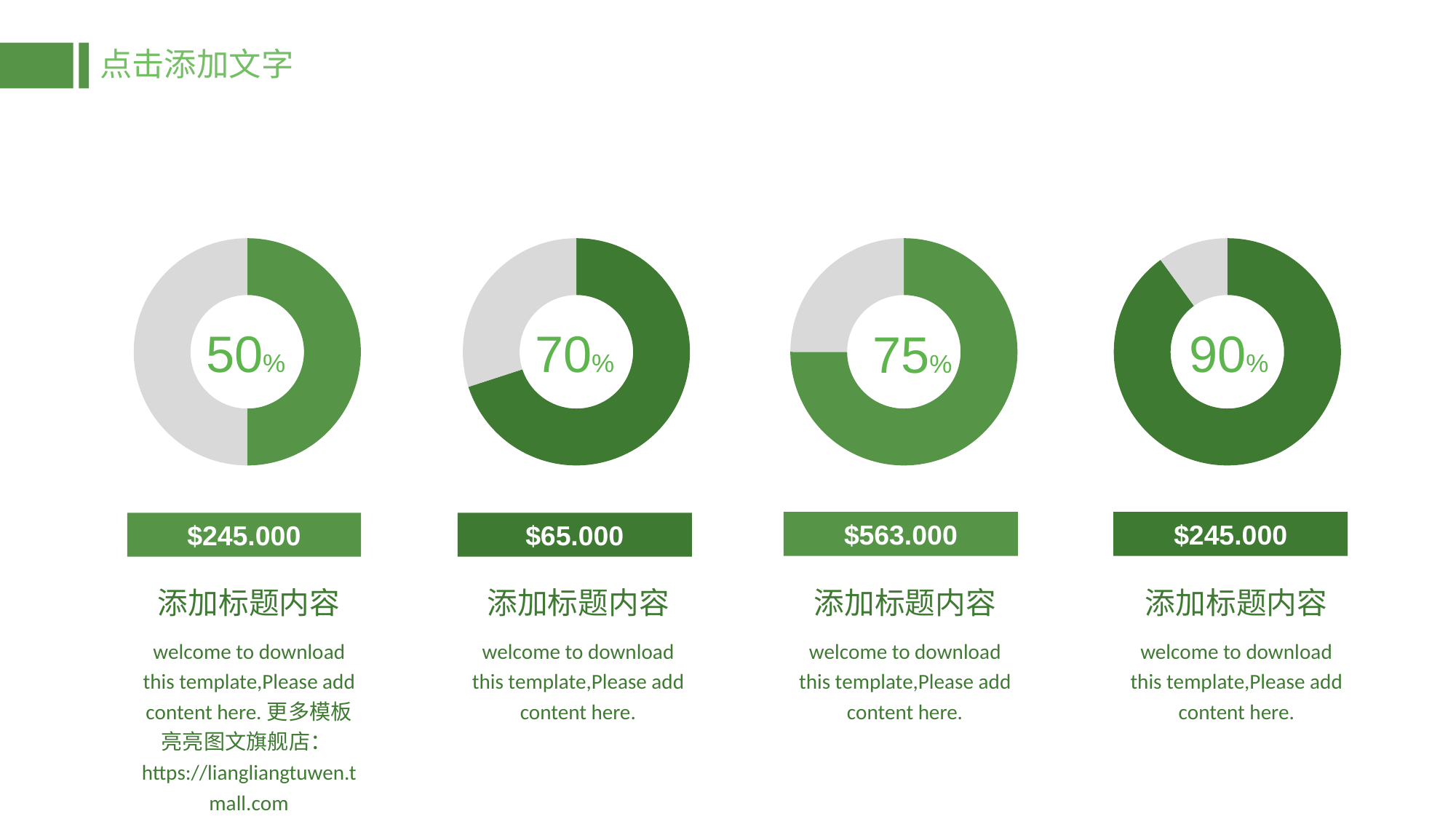
How many donut charts are on the slide? 4 What kind of chart is used four times across the middle of the slide? Donut chart What percentage is shown in the centre of the third donut chart from the left? 75% What is the difference between the percentage in the rightmost donut chart and the percentage in the leftmost donut chart? 40% Which donut chart shows the lowest percentage? The leftmost one (50%) Which donut chart shows the highest percentage? The rightmost one (90%) In the leftmost donut chart, what share of the ring is filled green? 50% Which shows a larger percentage, the second donut chart from the left or the third donut chart from the left? The third (75%) What percentage is shown in the centre of the rightmost donut chart? 90% What dollar value is printed in the bar below the third donut chart from the left? $563.000 What percentage is shown in the centre of the second donut chart from the left? 70% What percentage is shown in the centre of the leftmost donut chart? 50%